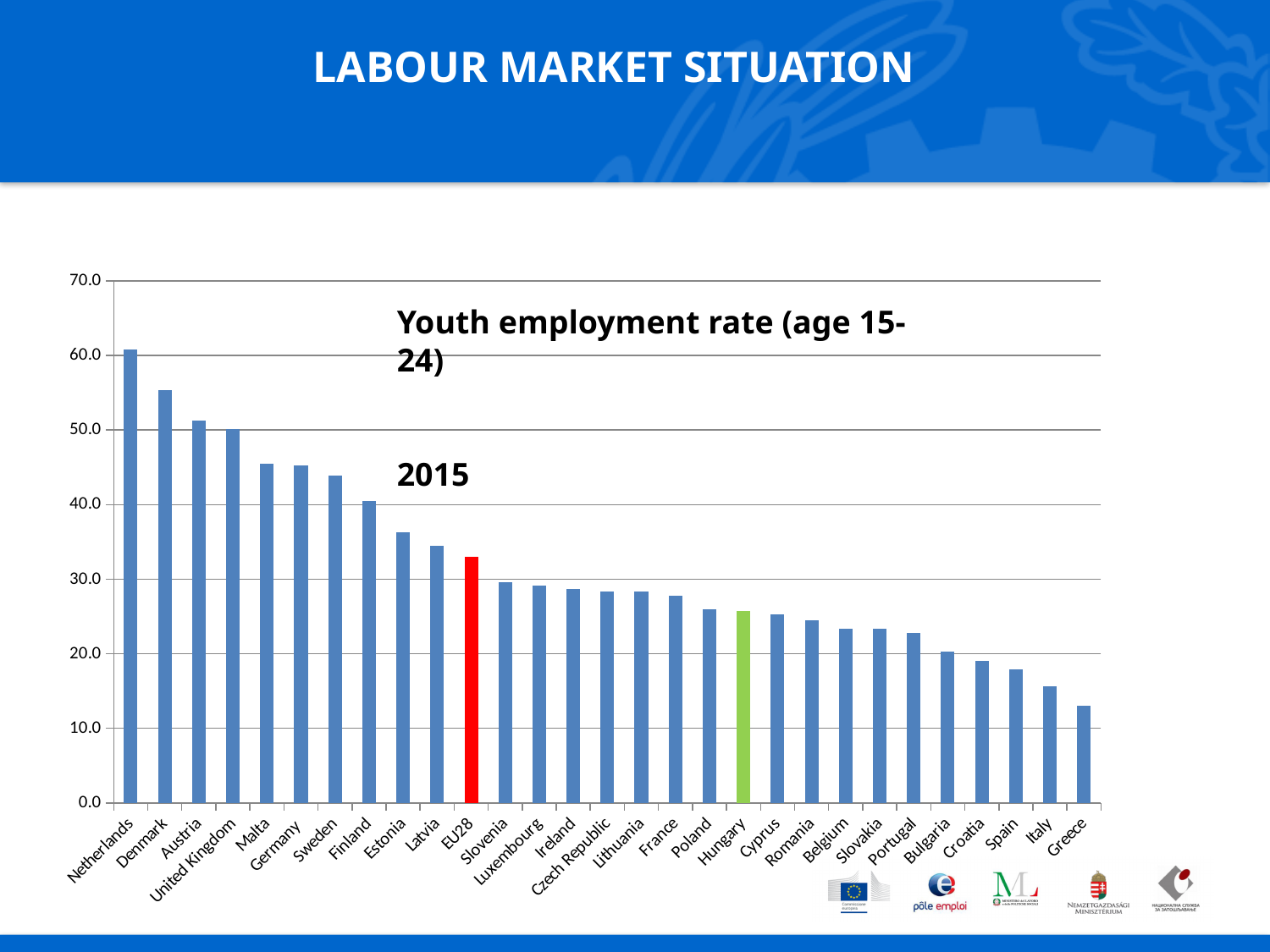
Is the value for Hungary greater or less than 30.0? less Which has a higher youth employment rate, Germany or Hungary? Germany Which bar is coloured red in the chart? EU28 Is the value for Netherlands greater or less than 50.0? greater Do the values rise or fall moving from left to right along the x axis? Fall Is the value for Estonia greater or less than 30.0? greater Which country has the lowest youth employment rate in the chart? Greece Which country has the highest youth employment rate in the chart? Netherlands Which year does the chart show data for? 2015 How many bars are plotted in the chart? 29 What kind of chart is shown on the slide? Bar chart